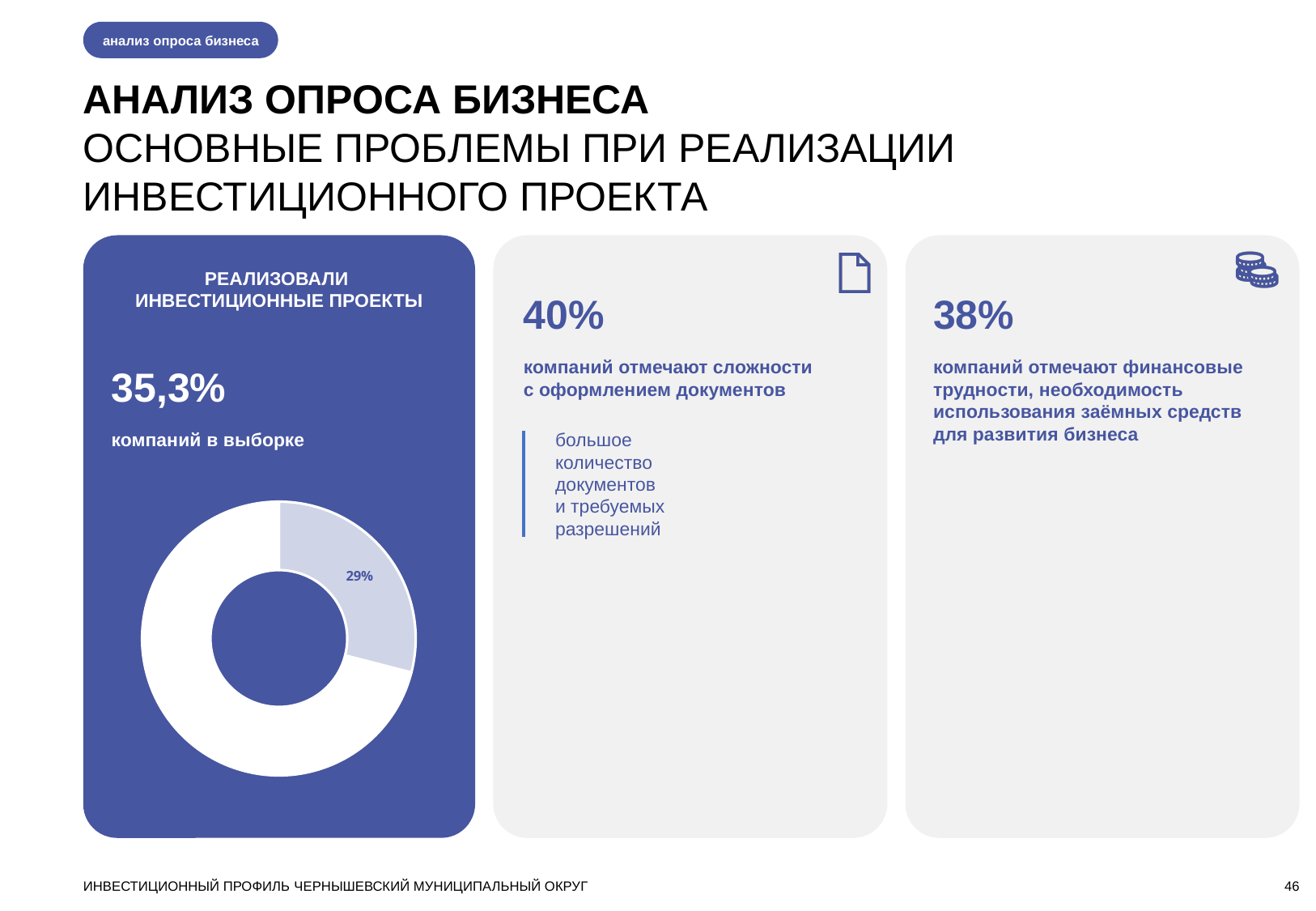
Is the labelled slice of the pie chart greater or less than half of the pie? less What is the heading of the card that contains the pie chart? РЕАЛИЗОВАЛИ ИНВЕСТИЦИОННЫЕ ПРОЕКТЫ Which slice of the pie chart is larger: the labelled slice or the unlabelled slice? The unlabelled slice What colour is the slice labelled 29% on the pie chart? Light lavender What kind of chart is shown on the slide? Pie (donut) chart What share of the pie does the labelled slice represent? 29% What percentage is printed as the data label on the pie chart? 29% How many slices does the pie chart have? 2